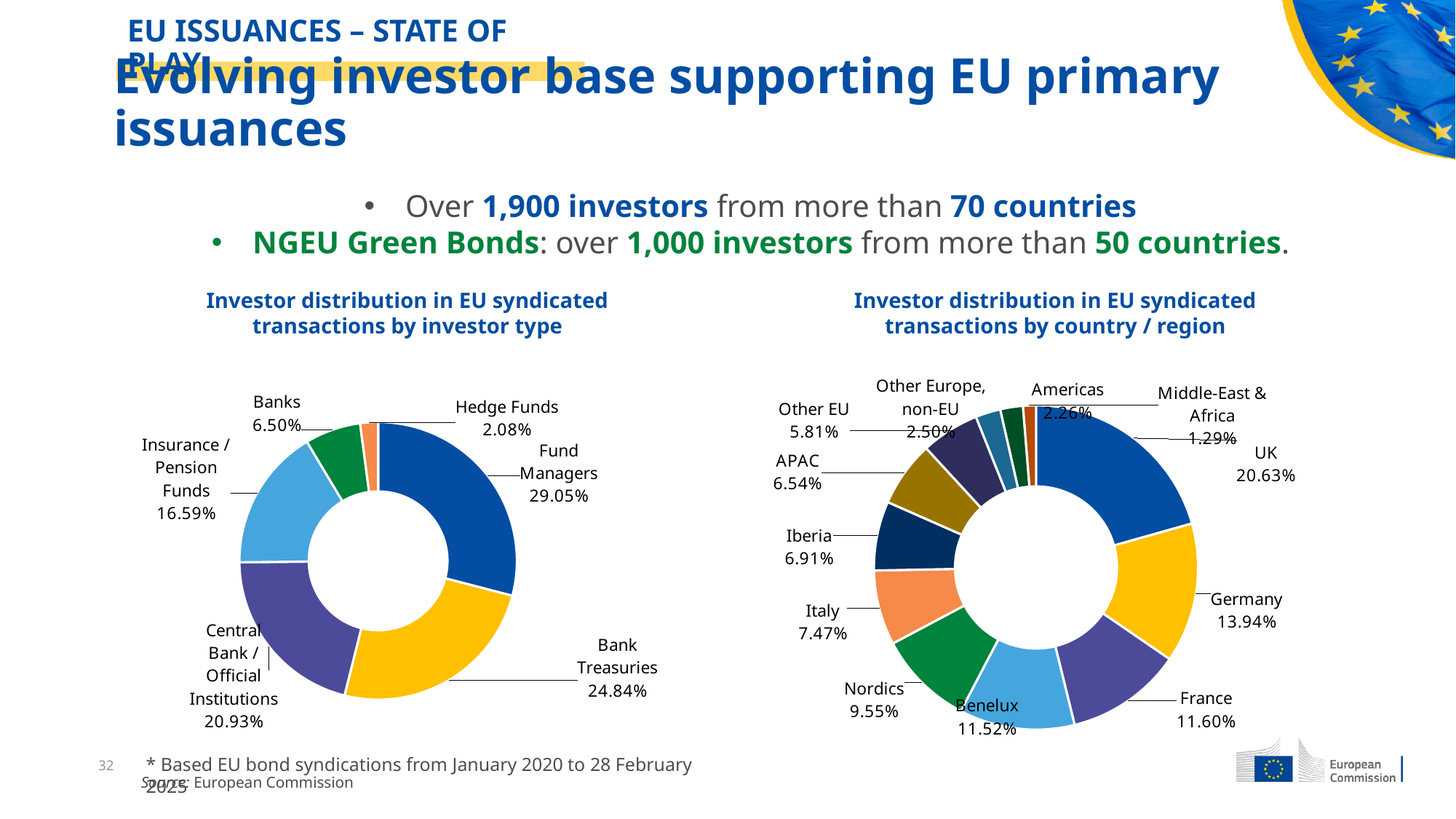
In the chart 'Investor distribution in EU syndicated transactions by investor type', what share do Insurance / Pension Funds hold? 16.59% In the chart 'Investor distribution in EU syndicated transactions by investor type', how many investor types are shown? 6 In the chart 'Investor distribution in EU syndicated transactions by investor type', which investor type has the smallest share? Hedge Funds In the chart 'Investor distribution in EU syndicated transactions by country / region', which has the larger share, Germany or France? Germany What kind of chart is 'Investor distribution in EU syndicated transactions by country / region'? Pie (donut) chart In the chart 'Investor distribution in EU syndicated transactions by investor type', which investor type has the largest share? Fund Managers In the chart 'Investor distribution in EU syndicated transactions by investor type', what share do Fund Managers hold? 29.05% In the chart 'Investor distribution in EU syndicated transactions by country / region', how many countries or regions are shown? 12 In the chart 'Investor distribution in EU syndicated transactions by country / region', what share does Italy hold? 7.47% In the chart 'Investor distribution in EU syndicated transactions by investor type', what is the difference between the shares of Fund Managers and Bank Treasuries? 4.21% In the chart 'Investor distribution in EU syndicated transactions by country / region', what share does the UK hold? 20.63% In the chart 'Investor distribution in EU syndicated transactions by country / region', which country or region has the smallest share? Middle-East & Africa